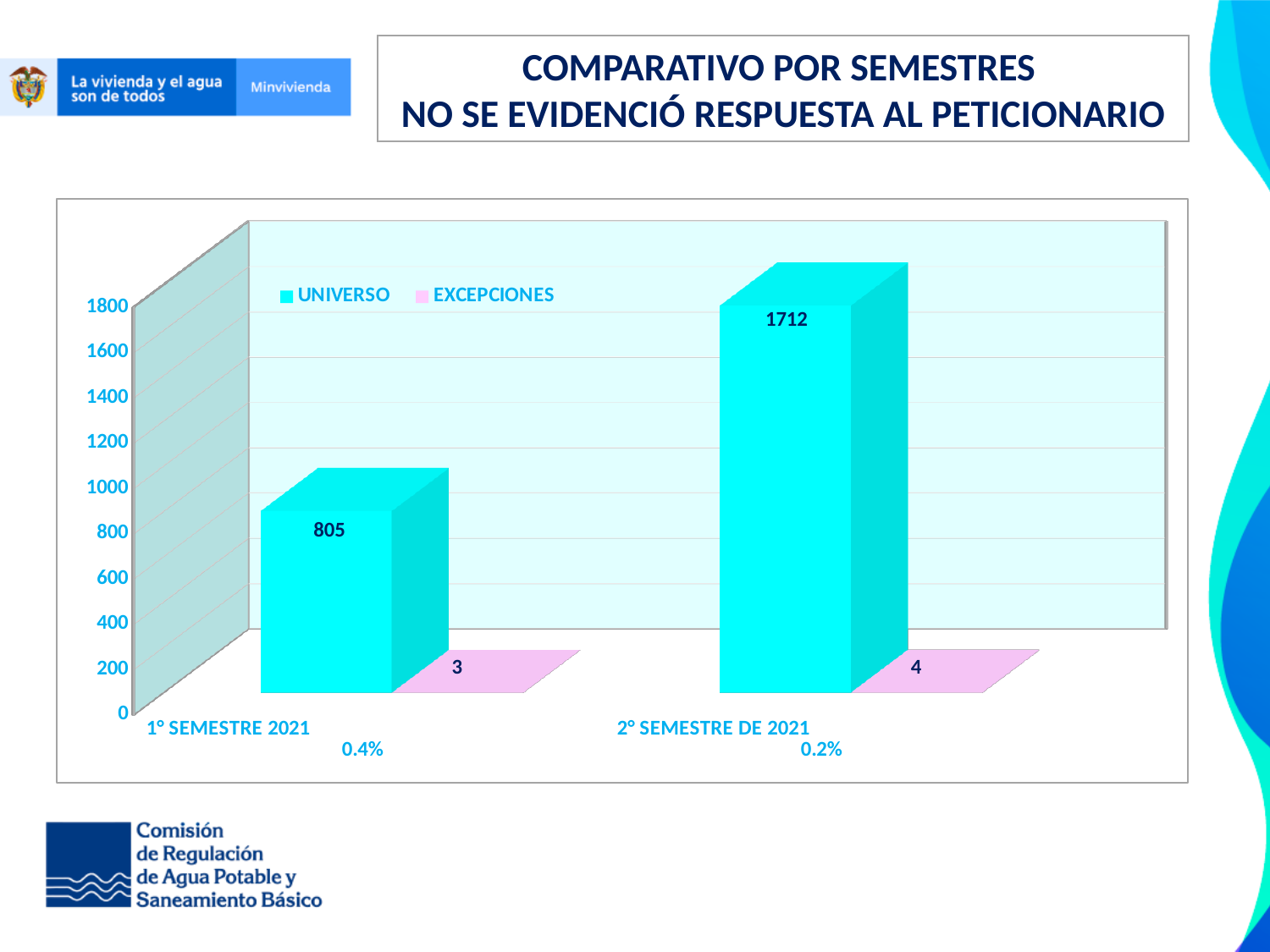
Does the UNIVERSO value rise or fall from 1° SEMESTRE 2021 to 2° SEMESTRE DE 2021? rise What is the EXCEPCIONES value for 1° SEMESTRE 2021? 3 What is the difference between the UNIVERSO values of 2° SEMESTRE DE 2021 and 1° SEMESTRE 2021? 907 What is the UNIVERSO value for 1° SEMESTRE 2021? 805 What kind of chart is shown on the slide? bar chart Is the UNIVERSO value for 1° SEMESTRE 2021 greater or less than 1000? less What is the EXCEPCIONES value for 2° SEMESTRE DE 2021? 4 How many series does the legend list? 2 Which semester has the higher UNIVERSO value? 2° SEMESTRE DE 2021 What percentage is printed below the 1° SEMESTRE 2021 category? 0.4% How many categories are shown on the x axis? 2 What is the UNIVERSO value for 2° SEMESTRE DE 2021? 1712